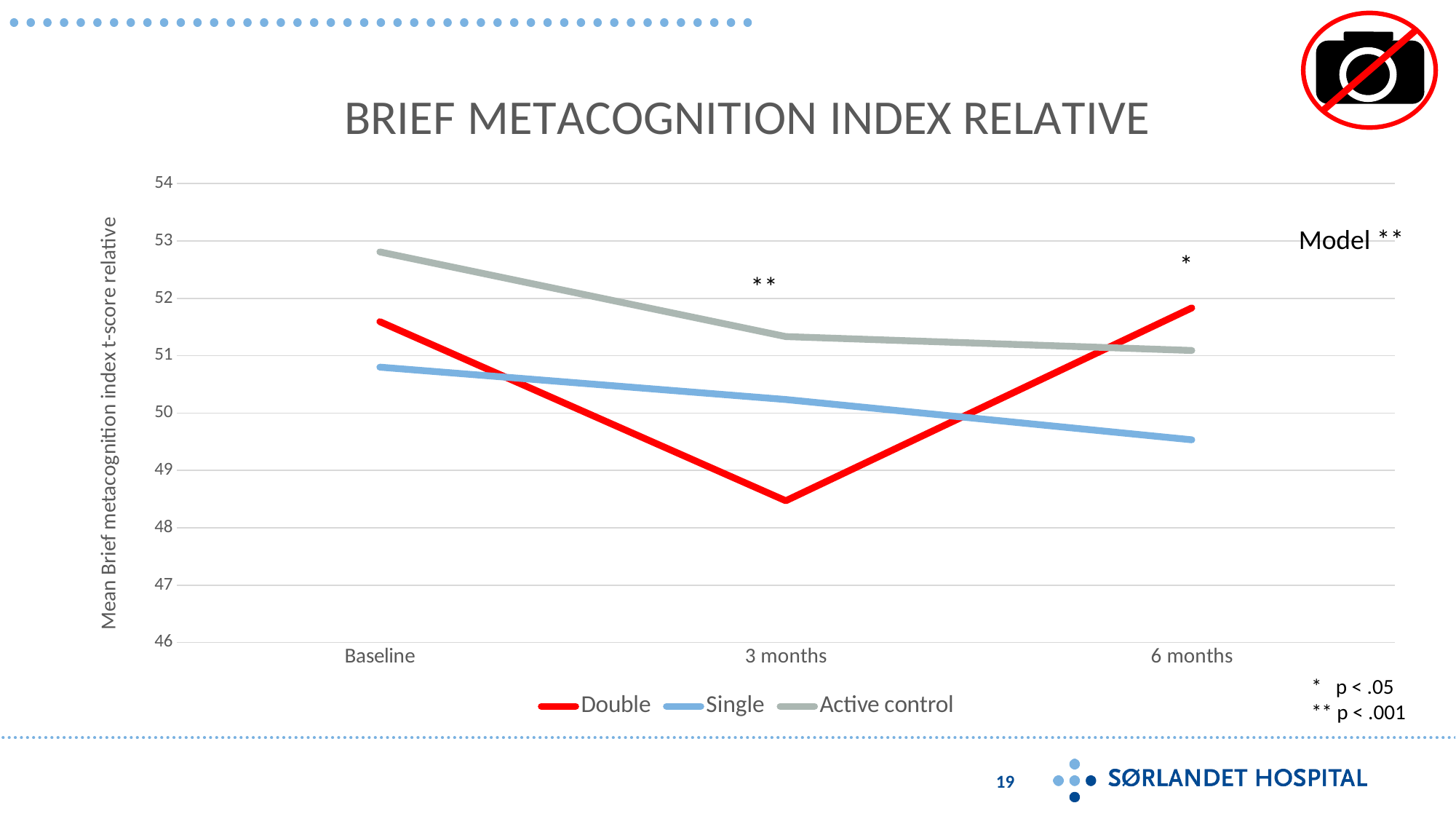
At 3 months, which is larger: Active control or Double? Active control How many series does the legend list? 3 Is the value for Active control at Baseline greater or less than 52? greater Is the value for Single at 6 months greater or less than 50? less What kind of chart is shown on the slide? line chart Is the value for Double at 3 months greater or less than 49? less Which series has the highest value at Baseline? Active control At 6 months, which is larger: Double or Single? Double Does the Single series rise or fall from Baseline to 6 months? fall Which series has the lowest value at 3 months? Double What is the title of the chart? BRIEF METACOGNITION INDEX RELATIVE How many time points are shown on the x axis? 3